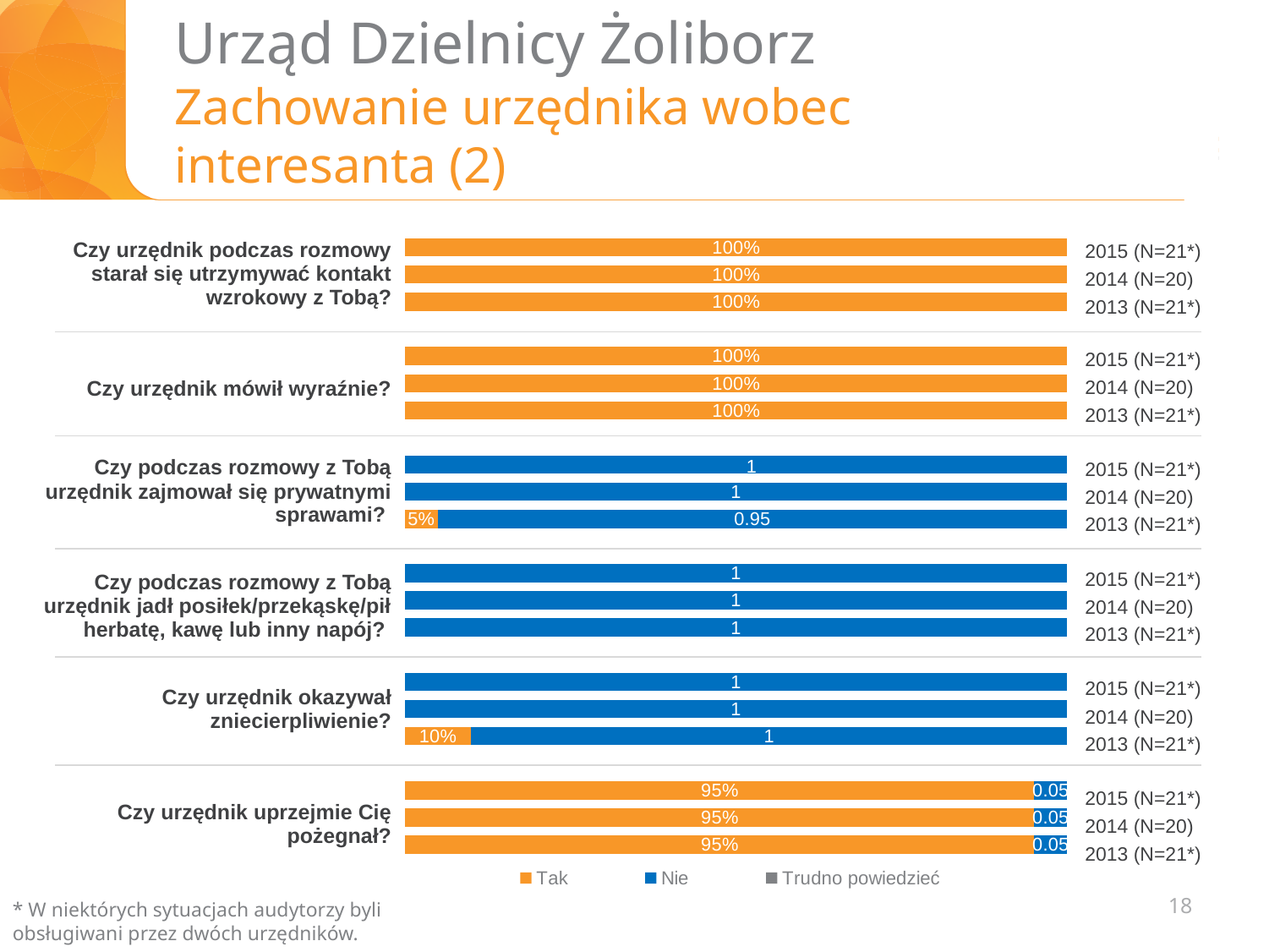
What is the 'Tak' value for 2014 (N=20) for the question 'Czy urzędnik uprzejmie Cię pożegnał?' 95% What is the 'Nie' value for 2013 (N=21*) for the question 'Czy podczas rozmowy z Tobą urzędnik zajmował się prywatnymi sprawami?' 0.95 Which is larger for 2013 (N=21*) in the question 'Czy urzędnik okazywał zniecierpliwienie?': the 'Tak' bar or the 'Nie' bar? Nie What are the legend entries of the chart? Tak, Nie, Trudno powiedzieć What kind of chart is shown on the slide? bar chart What is the 'Nie' value for 2014 (N=20) for the question 'Czy podczas rozmowy z Tobą urzędnik jadł posiłek/przekąskę/pił herbatę, kawę lub inny napój?' 1 How many survey questions are shown on the chart? 6 What is the 'Nie' value for 2015 (N=21*) for the question 'Czy urzędnik uprzejmie Cię pożegnał?' 0.05 How many series does the legend list? 3 What is the 'Tak' value for 2015 (N=21*) for the question 'Czy urzędnik mówił wyraźnie?' 100% What is the 'Tak' value for 2013 (N=21*) for the question 'Czy urzędnik okazywał zniecierpliwienie?' 10% What is the 'Tak' value for 2013 (N=21*) for the question 'Czy podczas rozmowy z Tobą urzędnik zajmował się prywatnymi sprawami?' 5%